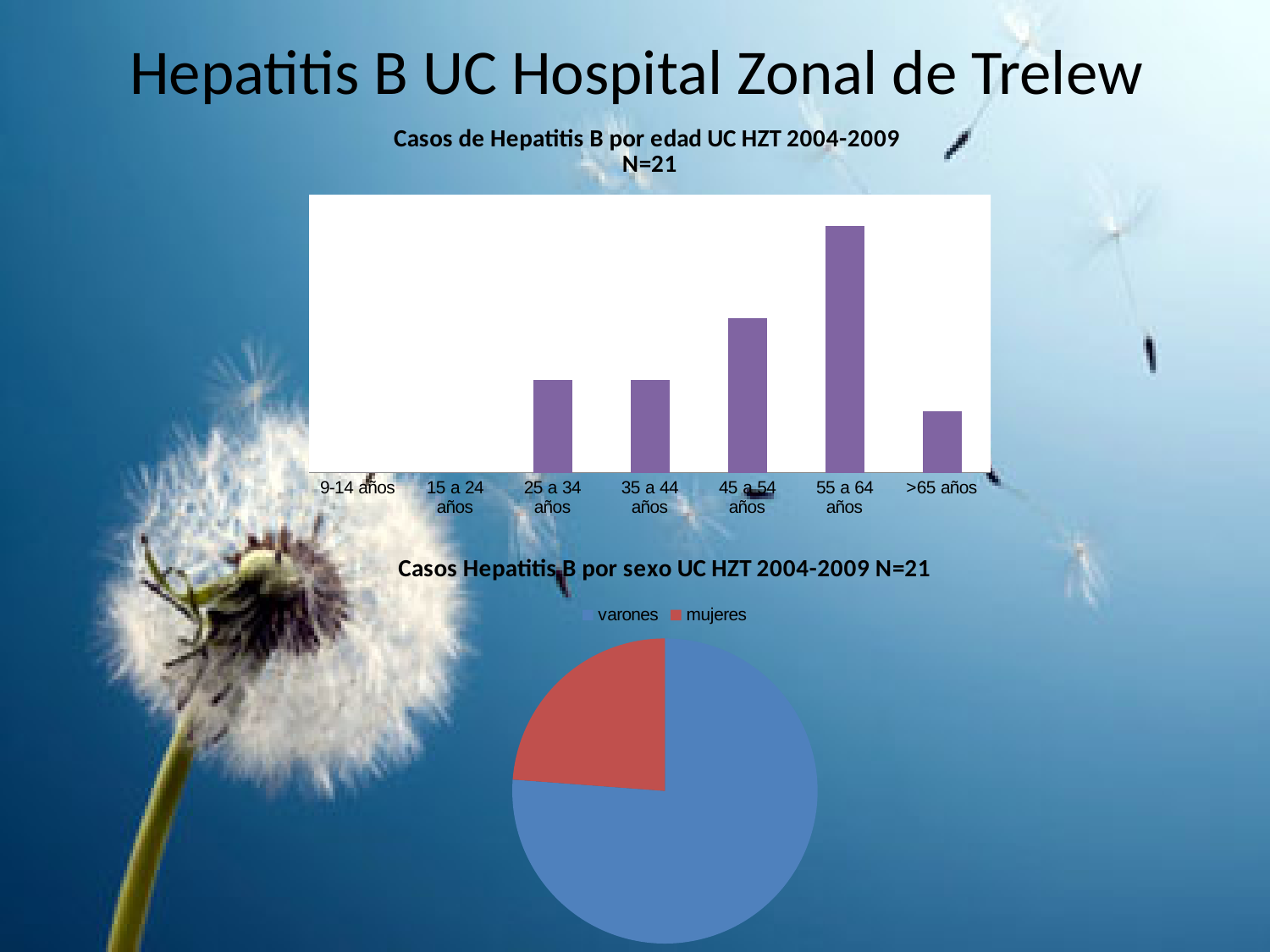
In the chart titled 'Casos de Hepatitis B por edad UC HZT 2004-2009 N=21', how many age categories are shown on the x axis? 7 In the chart titled 'Casos Hepatitis B por sexo UC HZT 2004-2009 N=21', which group has the larger share: varones or mujeres? varones In the chart titled 'Casos Hepatitis B por sexo UC HZT 2004-2009 N=21', what kind of chart is shown? pie chart In the chart titled 'Casos de Hepatitis B por edad UC HZT 2004-2009 N=21', what colour are the bars? purple In the chart titled 'Casos Hepatitis B por sexo UC HZT 2004-2009 N=21', how many entries does the legend list? 2 In the chart titled 'Casos de Hepatitis B por edad UC HZT 2004-2009 N=21', which has more cases: 25 a 34 años or 45 a 54 años? 45 a 54 años In the chart titled 'Casos de Hepatitis B por edad UC HZT 2004-2009 N=21', what kind of chart is shown? bar chart In the chart titled 'Casos de Hepatitis B por edad UC HZT 2004-2009 N=21', which age group has the highest number of cases? 55 a 64 años In the chart titled 'Casos de Hepatitis B por edad UC HZT 2004-2009 N=21', which has more cases: 45 a 54 años or 55 a 64 años? 55 a 64 años In the chart titled 'Casos Hepatitis B por sexo UC HZT 2004-2009 N=21', which legend entry is shown in red? mujeres